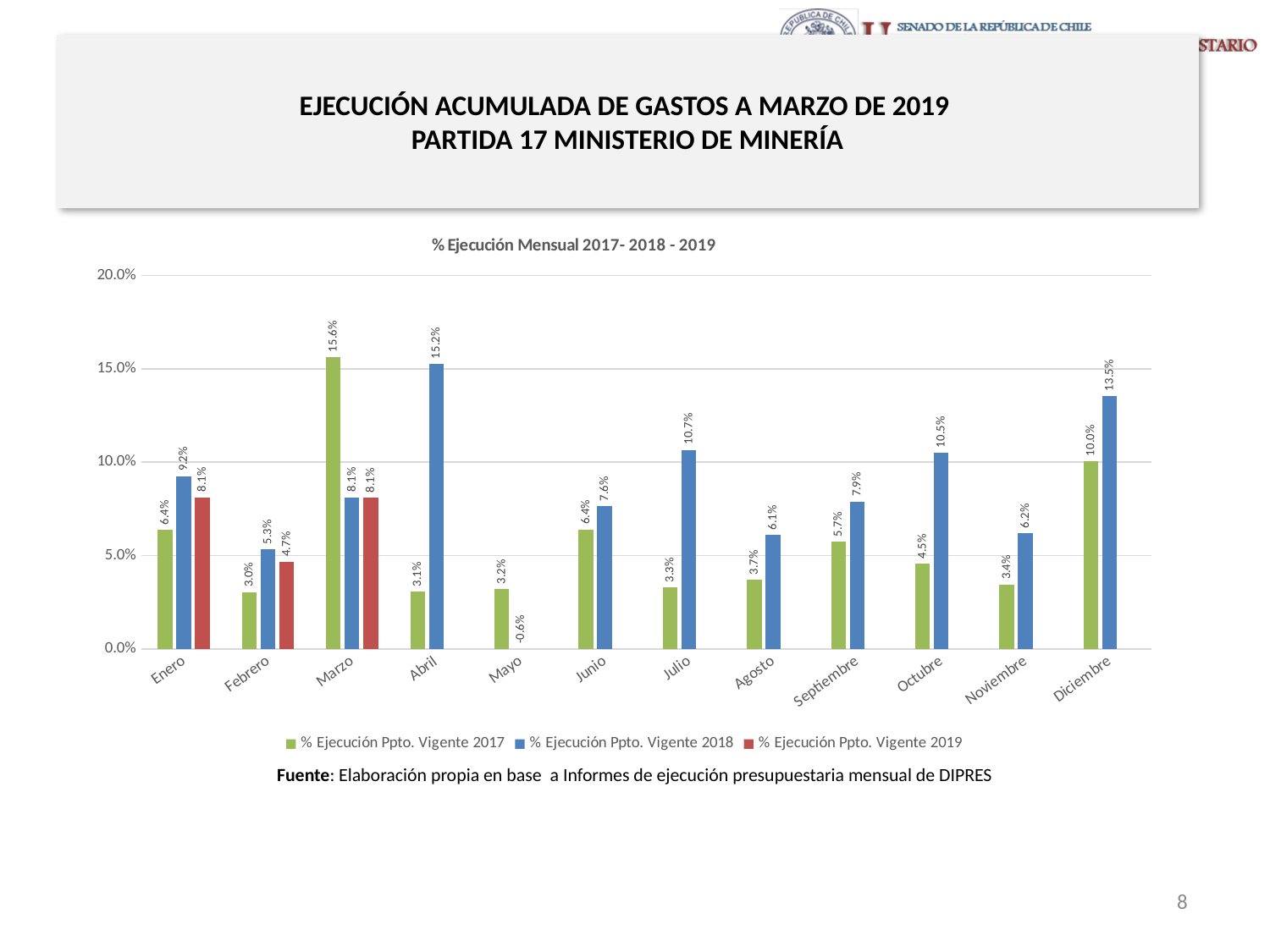
Which colour represents the % Ejecución Ppto. Vigente 2019 series? Red How many months are shown on the x axis? 12 How many series does the legend list? 3 What is the value for % Ejecución Ppto. Vigente 2017 in Diciembre? 10.0% What is the title of the chart? % Ejecución Mensual 2017- 2018 - 2019 What kind of chart is shown on the slide? Bar chart What is the difference between the 2018 and 2017 values in Julio? 7.4% In which month is the % Ejecución Ppto. Vigente 2017 series highest? Marzo What is the value for % Ejecución Ppto. Vigente 2019 in Febrero? 4.7% In which month is the % Ejecución Ppto. Vigente 2018 series lowest? Mayo What is the value for % Ejecución Ppto. Vigente 2018 in Abril? 15.2% In Enero, which series has the larger value: % Ejecución Ppto. Vigente 2018 or % Ejecución Ppto. Vigente 2019? % Ejecución Ppto. Vigente 2018